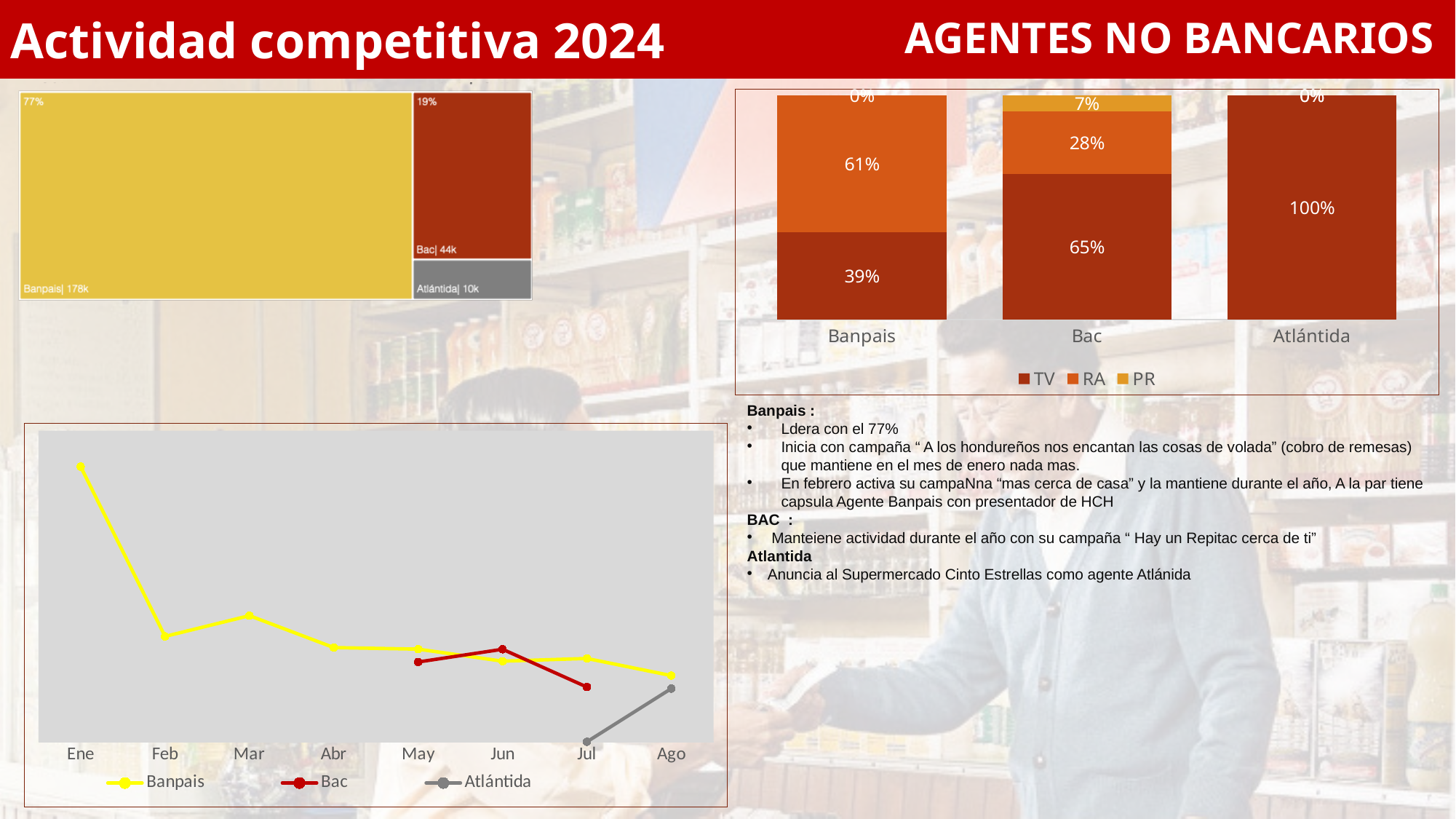
In the stacked bar chart at the top right, what is the TV share for Bac? 65% In the line chart at the bottom left, does the Banpais line rise or fall from Ene to Feb? fall In the stacked bar chart at the top right, what is the RA share for Banpais? 61% In the treemap chart at the top left, what value is shown for Banpais? 178k In the stacked bar chart at the top right, how many series does the legend list? 3 In the treemap chart at the top left, what value is shown for Bac? 44k In the treemap chart at the top left, which bank has the largest area? Banpais In the stacked bar chart at the top right, which bank has the highest TV share? Atlántida In the treemap chart at the top left, what is the difference between the Banpais and Bac values? 134k In the line chart at the bottom left, how many months are shown on the x axis? 8 In the stacked bar chart at the top right, what is the PR share for Bac? 7% In the treemap chart at the top left, what percentage is shown for Banpais? 77%